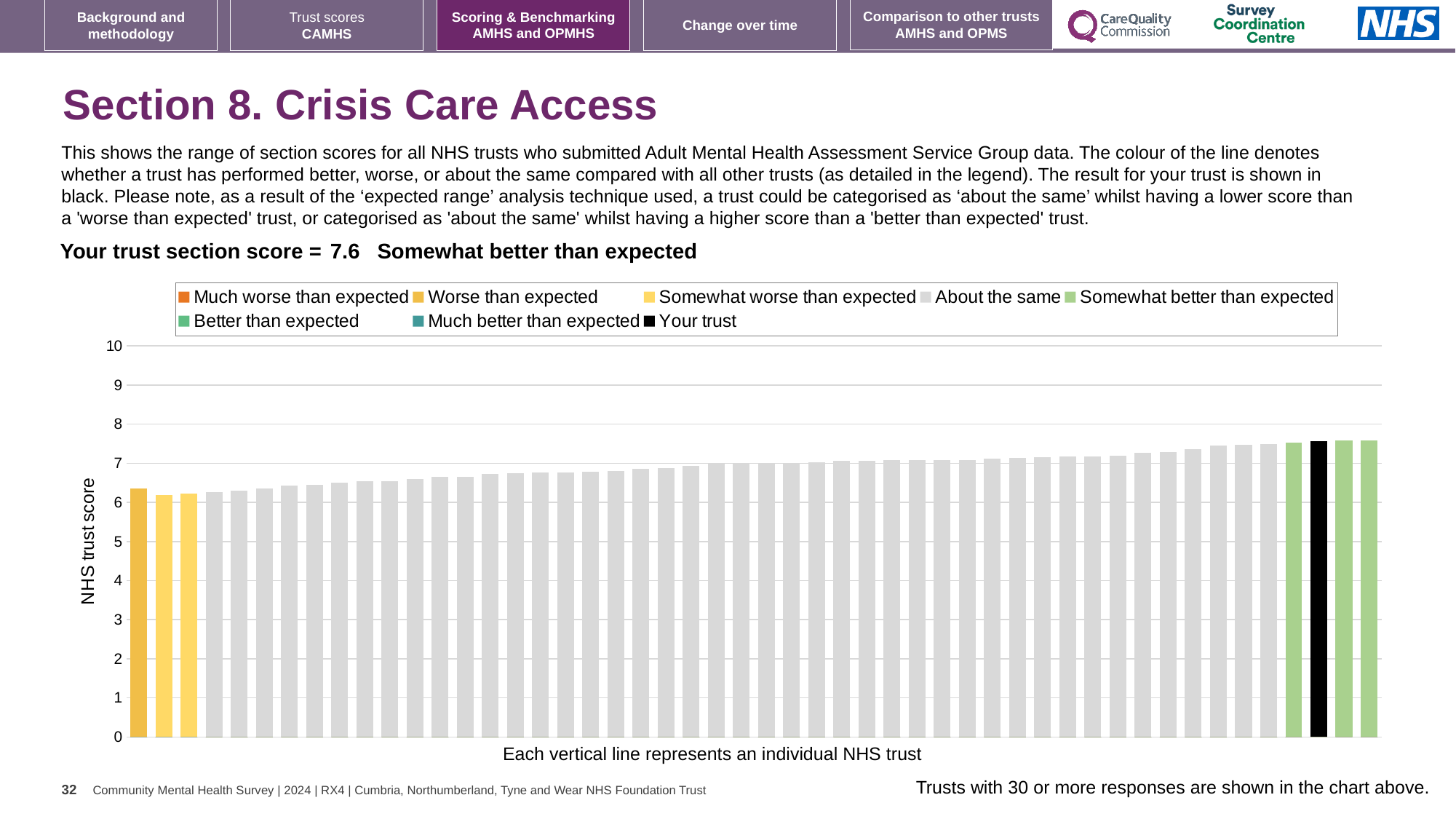
What is the section score for 'Your trust' shown on the slide? 7.6 How many entries does the chart legend list? 8 Is the value of the black 'Your trust' bar greater or less than 7? greater Which is larger: the black 'Your trust' bar or the leftmost bar? The black 'Your trust' bar What is the label on the vertical axis of the chart? NHS trust score Do the bar values rise or fall from left to right along the x axis? Rise Is the value of the leftmost bar greater or less than 7? less How many bars are coloured green ('Somewhat better than expected')? 3 What kind of chart is shown on the slide? Bar chart How many bars are coloured black for 'Your trust'? 1 Is the value of the tallest bar greater or less than 8? less What colour does the legend use for 'Your trust'? Black